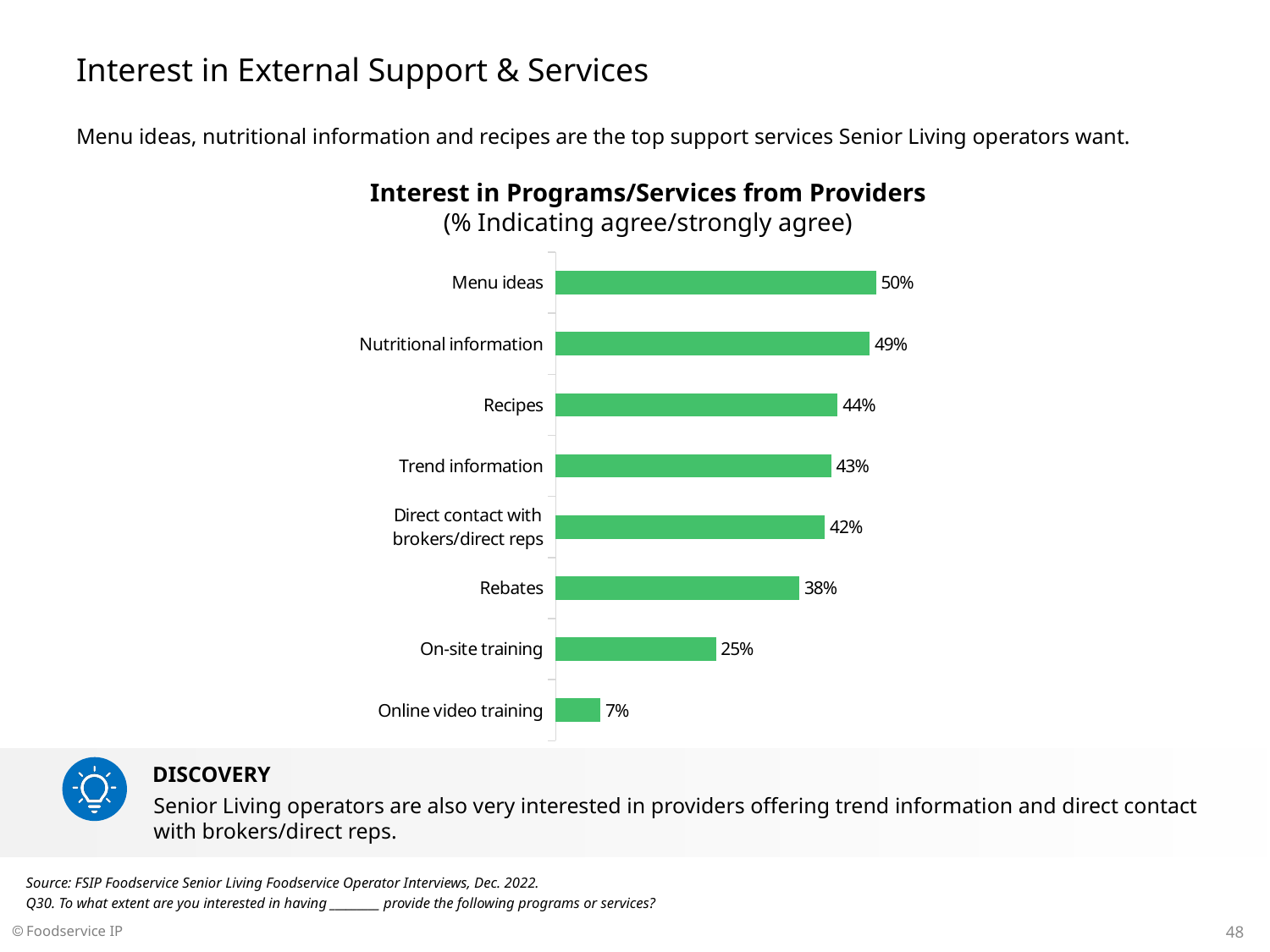
Which has a higher value, Recipes or Rebates? Recipes Which program/service has the lowest percentage of interest? Online video training What percentage of Senior Living operators indicated interest in Menu ideas? 50% What is the difference in percentage points between Menu ideas and Rebates? 12 What is the title of the chart? Interest in Programs/Services from Providers Which program/service has the highest percentage of interest? Menu ideas What is the value shown for Direct contact with brokers/direct reps? 42% Which has a higher value, On-site training or Trend information? Trend information How many programs/services are shown in the chart? 8 What is the value shown for Rebates? 38% What type of chart is used on this slide? Bar chart What is the difference in percentage points between On-site training and Online video training? 18